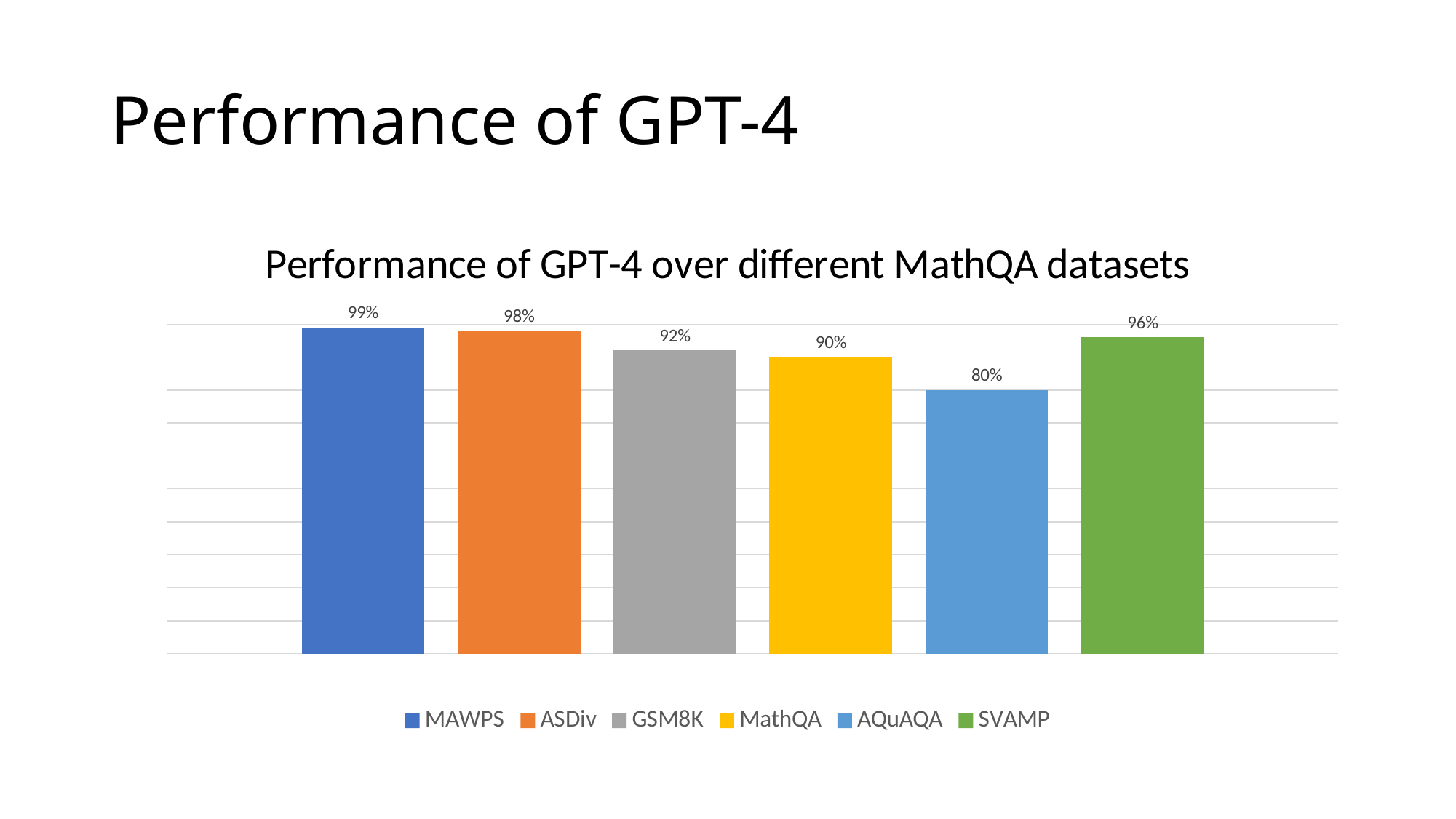
What kind of chart is shown on the slide? Bar chart What is the value for MAWPS? 99% What is the value for AQuAQA? 80% How many datasets are shown in the chart? 6 What is the difference between the values for MAWPS and AQuAQA? 19% What is the value for SVAMP? 96% What is the difference between the values for SVAMP and MathQA? 6% Which is larger, the value for GSM8K or the value for SVAMP? SVAMP Which dataset has the lowest value? AQuAQA What is the value for GSM8K? 92% Which dataset has the highest value? MAWPS What is the title of the chart? Performance of GPT-4 over different MathQA datasets